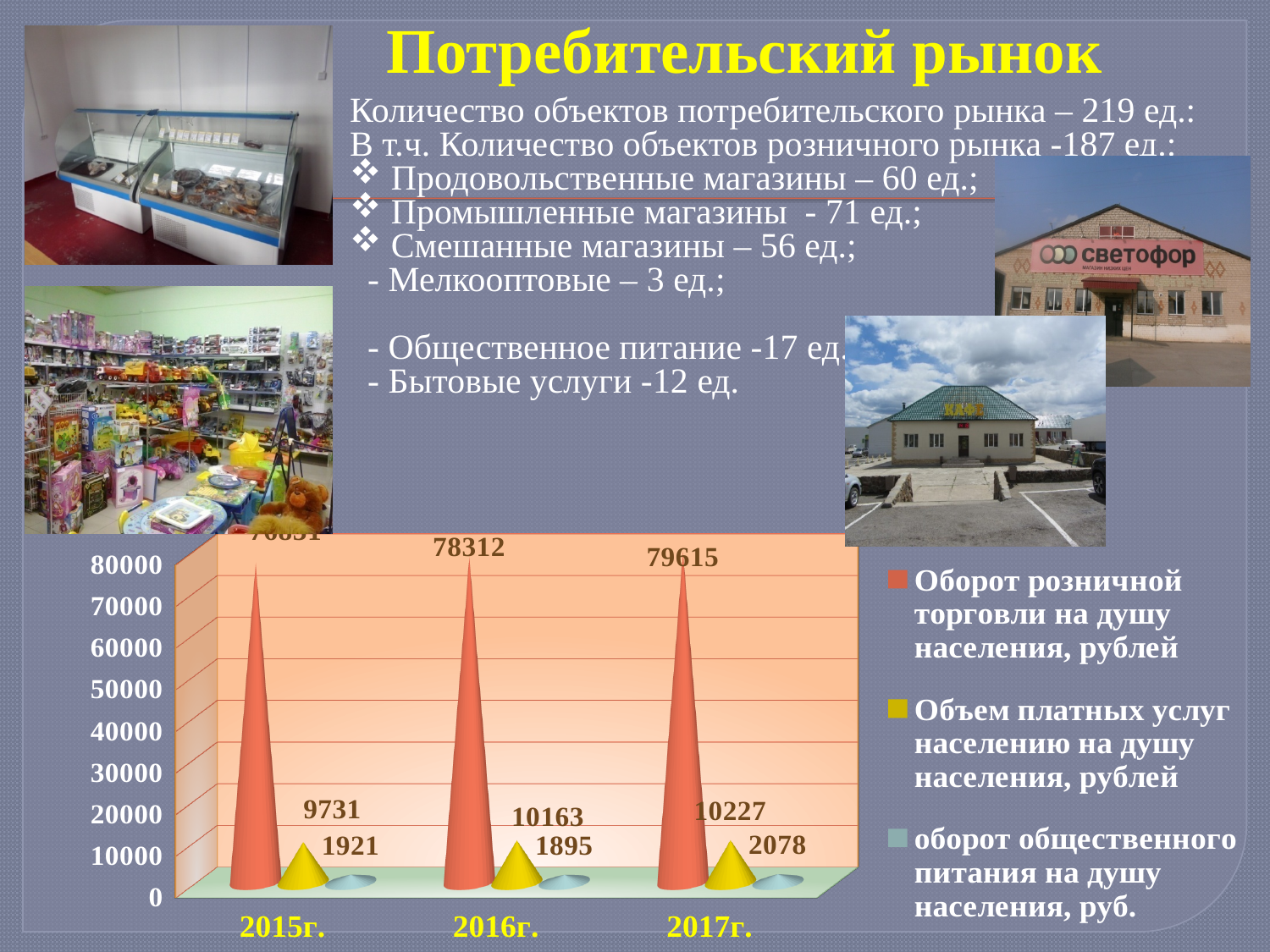
How many series does the chart legend list? 3 Is the retail trade turnover per capita for 2015г. greater or less than 70000? greater Does paid services per capita rise or fall from 2015г. to 2017г.? rise What is the difference between paid services per capita in 2017г. and 2016г.? 64 In which year is public catering turnover per capita the lowest? 2016г. What is the value of retail trade turnover per capita (Оборот розничной торговли на душу населения) for 2016г.? 78312 By how much did retail trade turnover per capita increase from 2016г. to 2017г.? 1303 What is the value of public catering turnover per capita (оборот общественного питания на душу населения) for 2017г.? 2078 What is the value of paid services per capita (Объем платных услуг населению на душу населения) for 2015г.? 9731 Which year has the higher public catering turnover per capita, 2015г. or 2016г.? 2015г. What is the value of retail trade turnover per capita for 2017г.? 79615 In which year is paid services per capita the highest? 2017г.